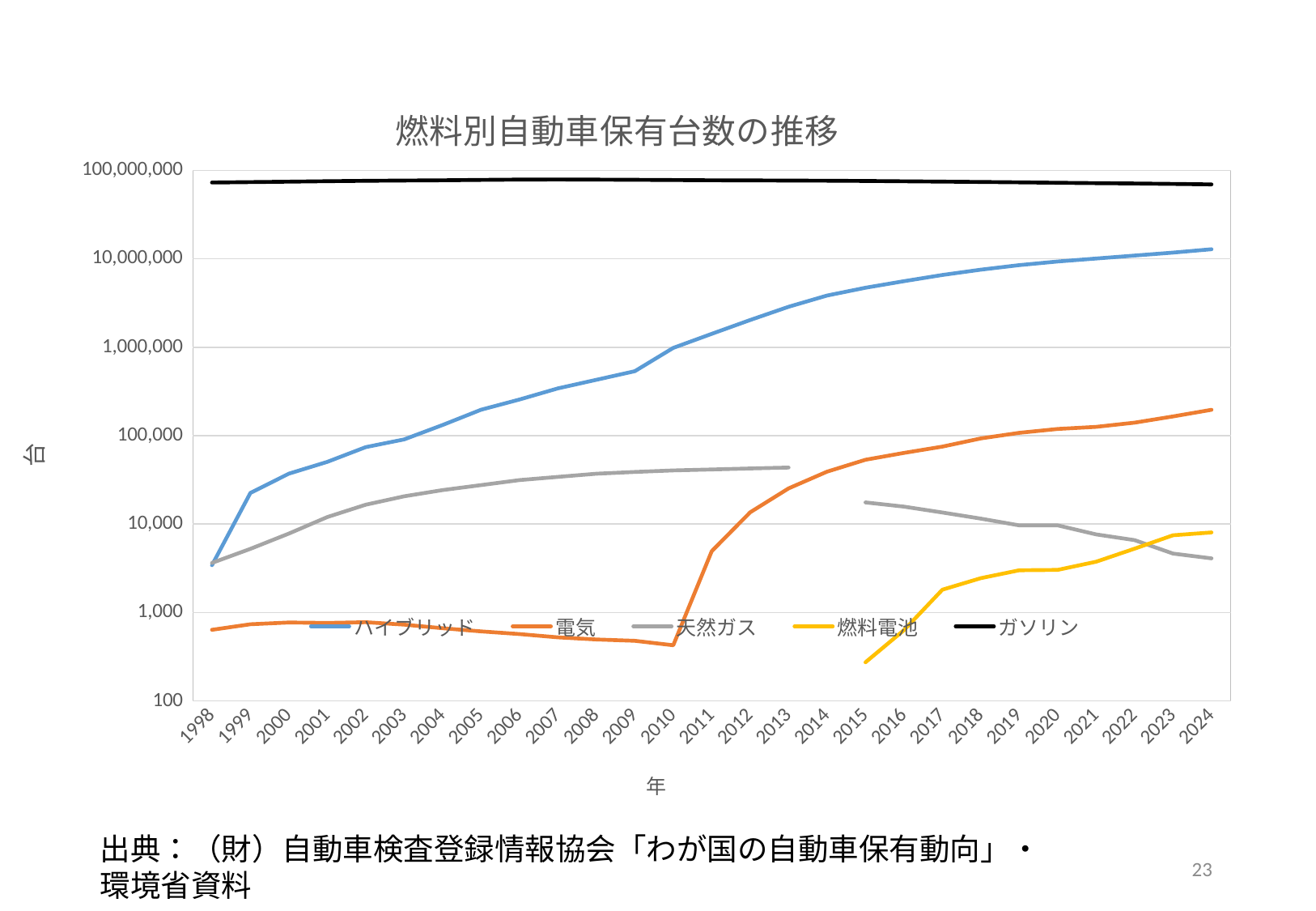
Is the value for 電気 in 2010 greater or less than 1,000? less How many years are shown on the x axis? 27 Is the value for 天然ガス in 2024 greater or less than 10,000? less Which series has the highest values across the whole period? ガソリン What is the title of the chart? 燃料別自動車保有台数の推移 What kind of chart is shown on the slide? Line chart Which is larger in 2024, ハイブリッド or 電気? ハイブリッド Which series has the lowest value in 2024? 天然ガス Does the 天然ガス line rise or fall from 2015 to 2024? Fall Which is larger in 2024, 燃料電池 or 天然ガス? 燃料電池 How many series does the legend list? 5 Is the value for ハイブリッド in 2024 greater or less than 10,000,000? greater